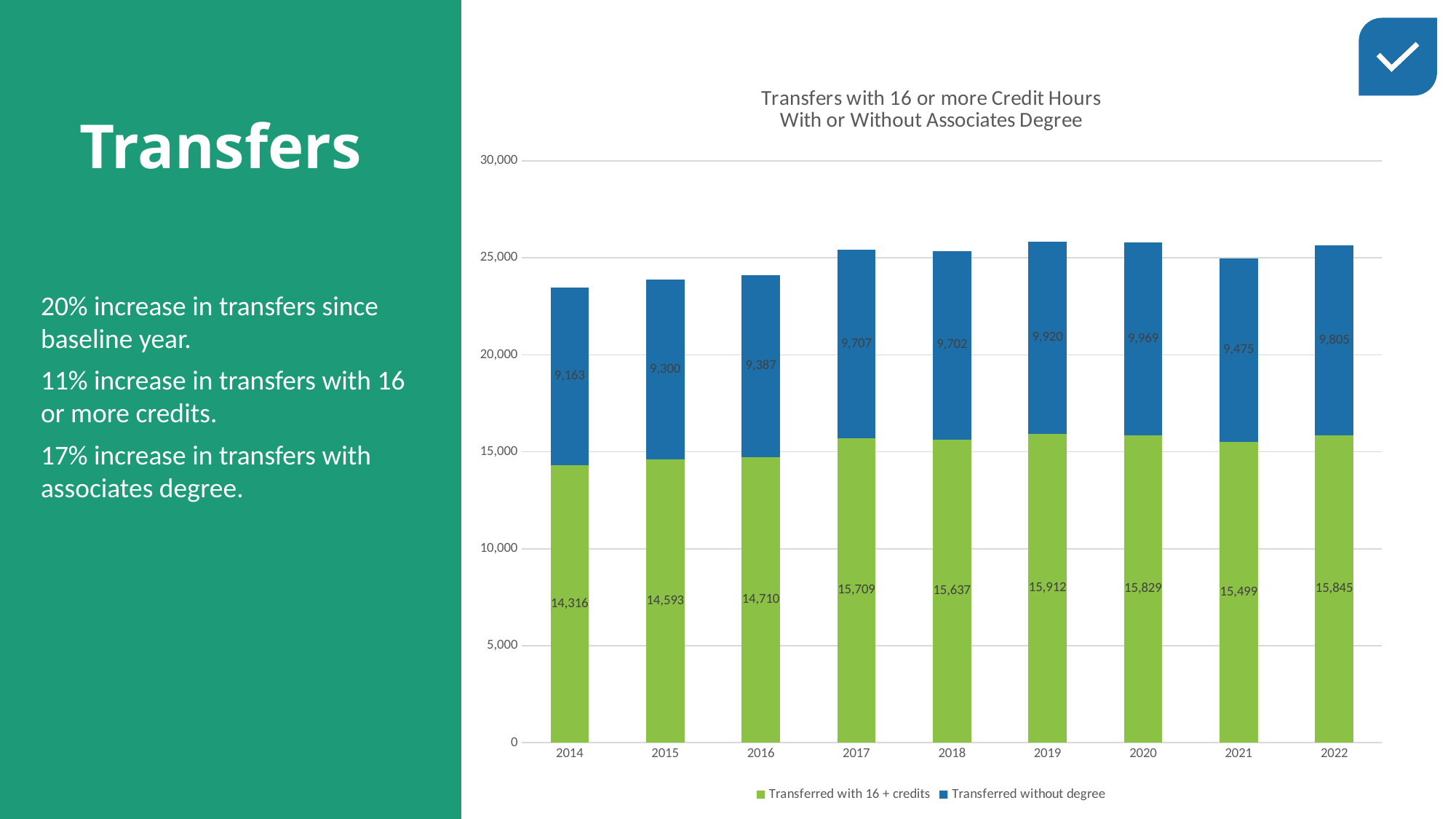
Which year has the lowest value for Transferred without degree? 2014 What is the difference between the Transferred with 16 + credits values for 2019 and 2014? 1,596 Is the total height of the stacked bar for 2014 greater or less than 25,000? less Which year has the highest value for Transferred without degree? 2020 What kind of chart is shown on the slide? Stacked bar chart How many years are shown on the x axis? 9 What is the value for Transferred without degree in 2022? 9,805 Which is larger, the Transferred with 16 + credits value for 2021 or for 2022? 2022 What is the total of the stacked bar for 2019? 25,832 How many series does the legend list? 2 Which year has the highest value for Transferred with 16 + credits? 2019 What is the value for Transferred with 16 + credits in 2014? 14,316